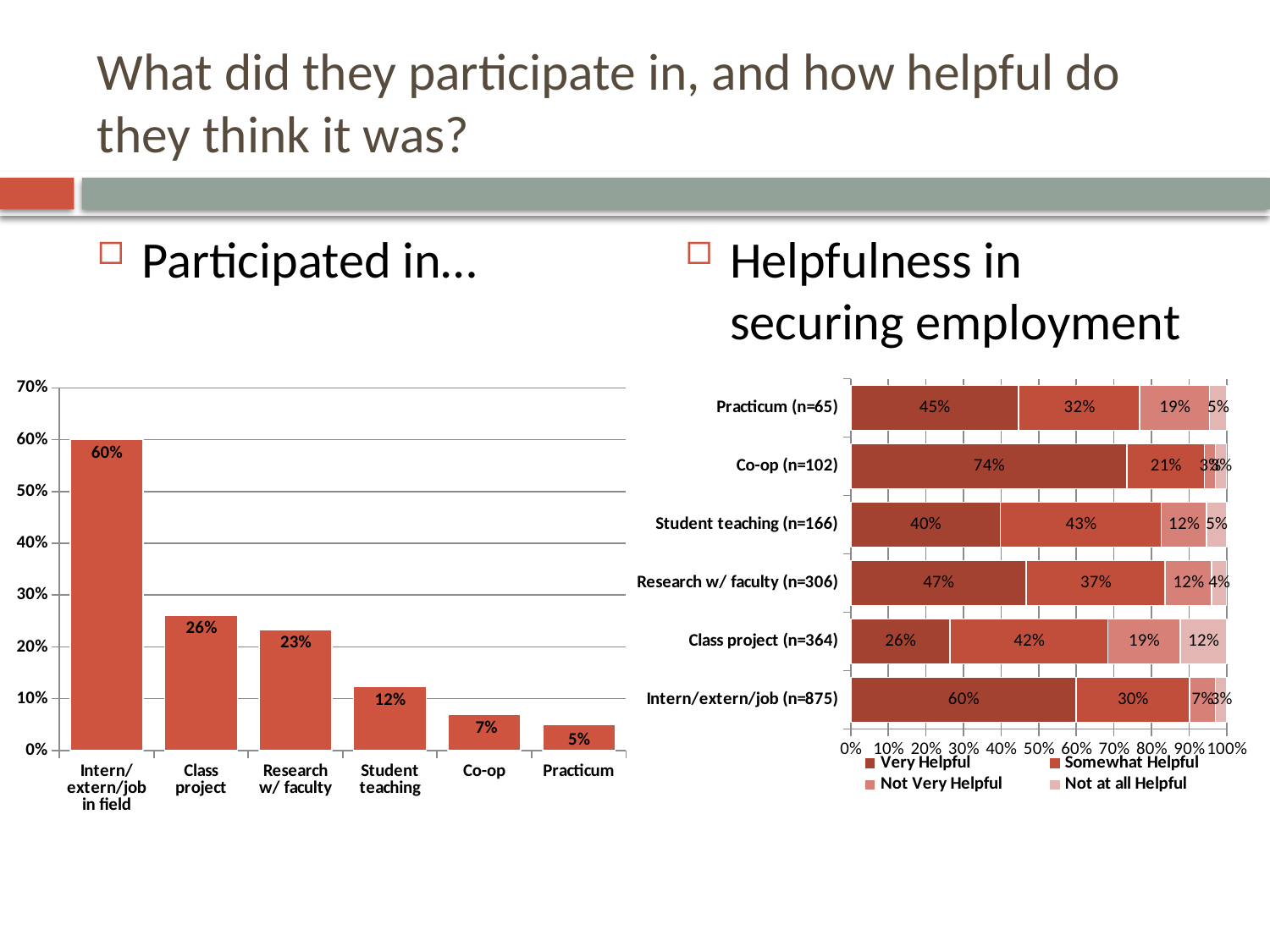
In the 'Participated in…' chart, how many categories are shown? 6 In the 'Participated in…' chart, what percentage participated in a class project? 26% In the 'Participated in…' chart, which category has the lowest value? Practicum In the 'Participated in…' chart, what is the difference between the values for Research w/ faculty and Student teaching? 11% In the 'Participated in…' chart, which category has the highest value? Intern/extern/job in field In the 'Participated in…' chart, do the values rise or fall from left to right? fall In the 'Helpfulness in securing employment' chart, is the Somewhat Helpful percentage larger for Student teaching or for Practicum? Student teaching In the 'Helpfulness in securing employment' chart, what percentage rated Class project as Not at all Helpful? 12% In the 'Helpfulness in securing employment' chart, how many series does the legend list? 4 What kind of chart is the 'Helpfulness in securing employment' chart? stacked bar chart In the 'Helpfulness in securing employment' chart, what percentage rated Co-op as Very Helpful? 74% In the 'Helpfulness in securing employment' chart, which category has the highest Very Helpful percentage? Co-op (n=102)